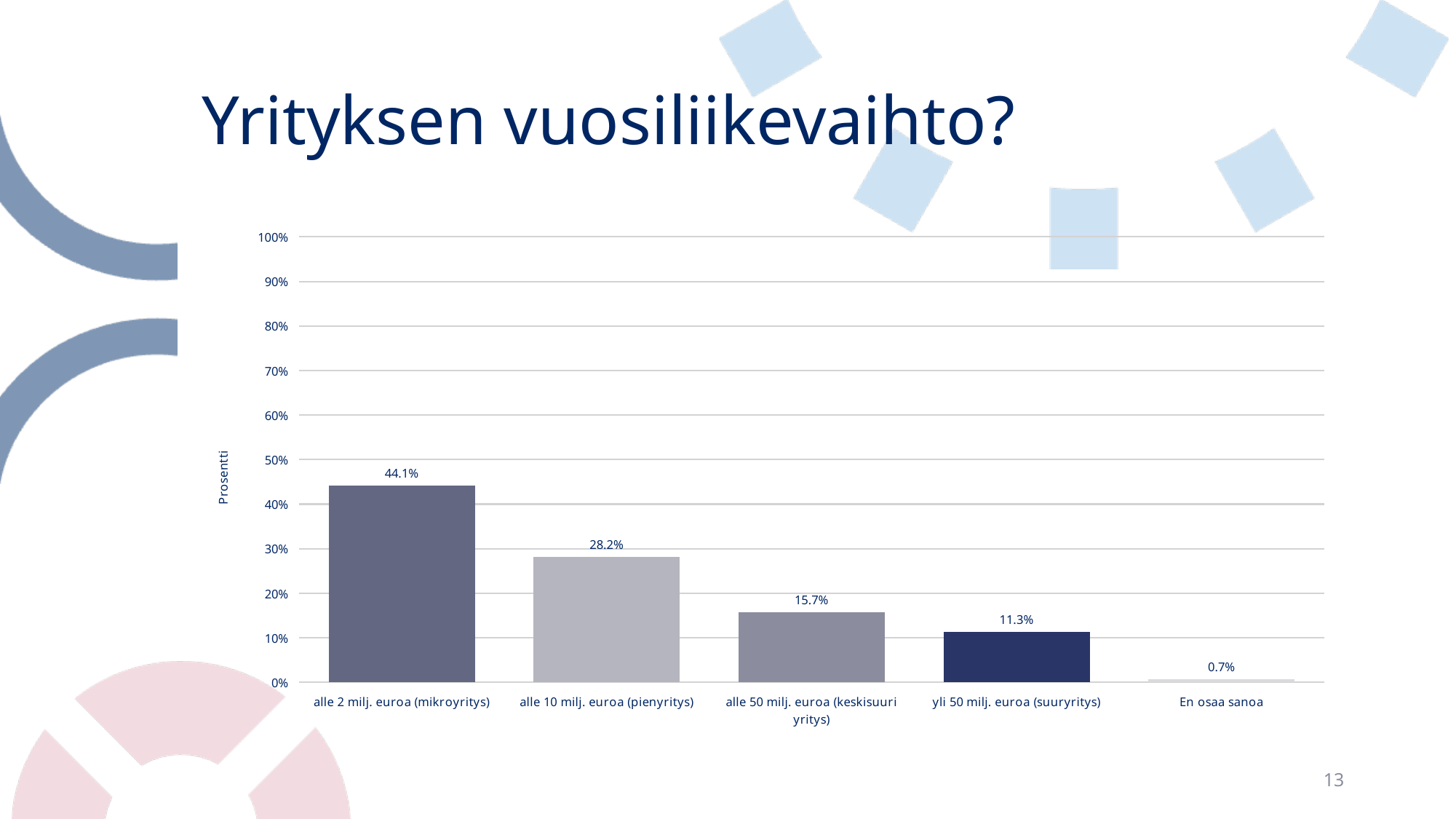
What is the value for 'yli 50 milj. euroa (suuryritys)'? 11.3% What is the value for 'alle 10 milj. euroa (pienyritys)'? 28.2% What is the label of the vertical axis? Prosentti How many categories are shown on the x axis? 5 What is the value for 'En osaa sanoa'? 0.7% What is the value for 'alle 2 milj. euroa (mikroyritys)'? 44.1% What kind of chart is shown on the slide? bar chart What is the difference between the values for 'alle 2 milj. euroa (mikroyritys)' and 'alle 10 milj. euroa (pienyritys)'? 15.9% Is the value for 'alle 10 milj. euroa (pienyritys)' greater or less than 30%? less Which category has the lowest value? En osaa sanoa Which is larger: the value for 'alle 50 milj. euroa (keskisuuri yritys)' or 'yli 50 milj. euroa (suuryritys)'? alle 50 milj. euroa (keskisuuri yritys) Which category has the highest value? alle 2 milj. euroa (mikroyritys)